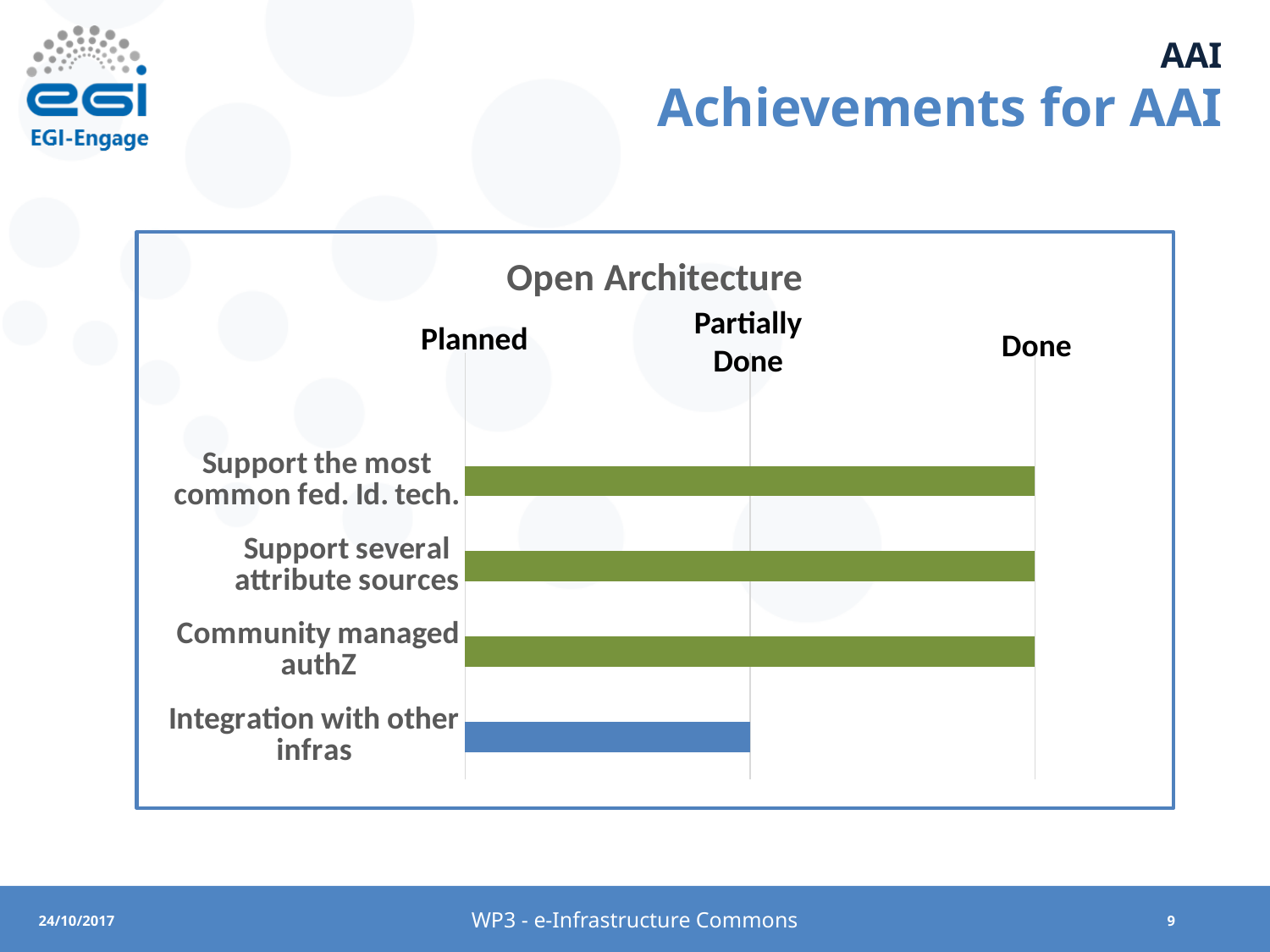
What status does the bar for 'Support several attribute sources' reach on the x axis? Done What is the title of the chart? Open Architecture What kind of chart is shown on the slide? bar chart Which category has the shortest bar in the chart? Integration with other infras What status does the bar for 'Community managed authZ' reach on the x axis? Done What are the three labels shown along the x axis of the chart? Planned, Partially Done, Done What status does the bar for 'Integration with other infras' reach on the x axis? Partially Done How many categories have reached the 'Done' mark? 3 How many categories are plotted in the chart? 4 What status does the bar for 'Support the most common fed. Id. tech.' reach on the x axis? Done Which bar is longer: 'Community managed authZ' or 'Integration with other infras'? Community managed authZ